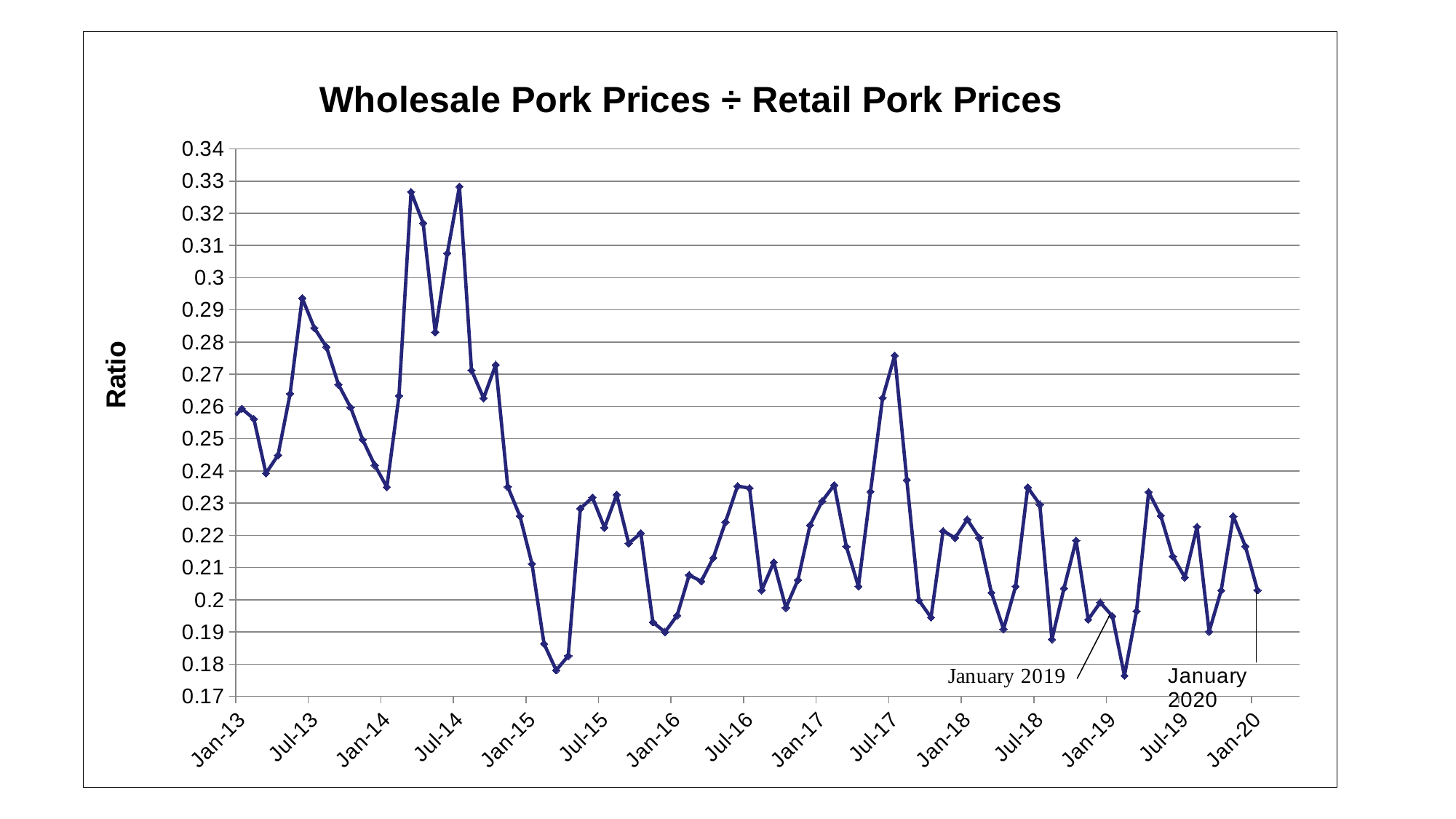
Is the value for Jan-19 greater or less than 0.2? less Overall, do the values rise or fall from Jan-13 to Jan-20? fall Which has the larger value, Jan-13 or Jan-20? Jan-13 Which has the larger value, Jul-17 or Jul-18? Jul-17 Is the value for Jan-13 greater or less than 0.25? greater Is the value for Jul-14 greater or less than 0.3? greater What is the title of the chart? Wholesale Pork Prices ÷ Retail Pork Prices What is the label on the vertical axis of the chart? Ratio What kind of chart is shown on the slide? line chart